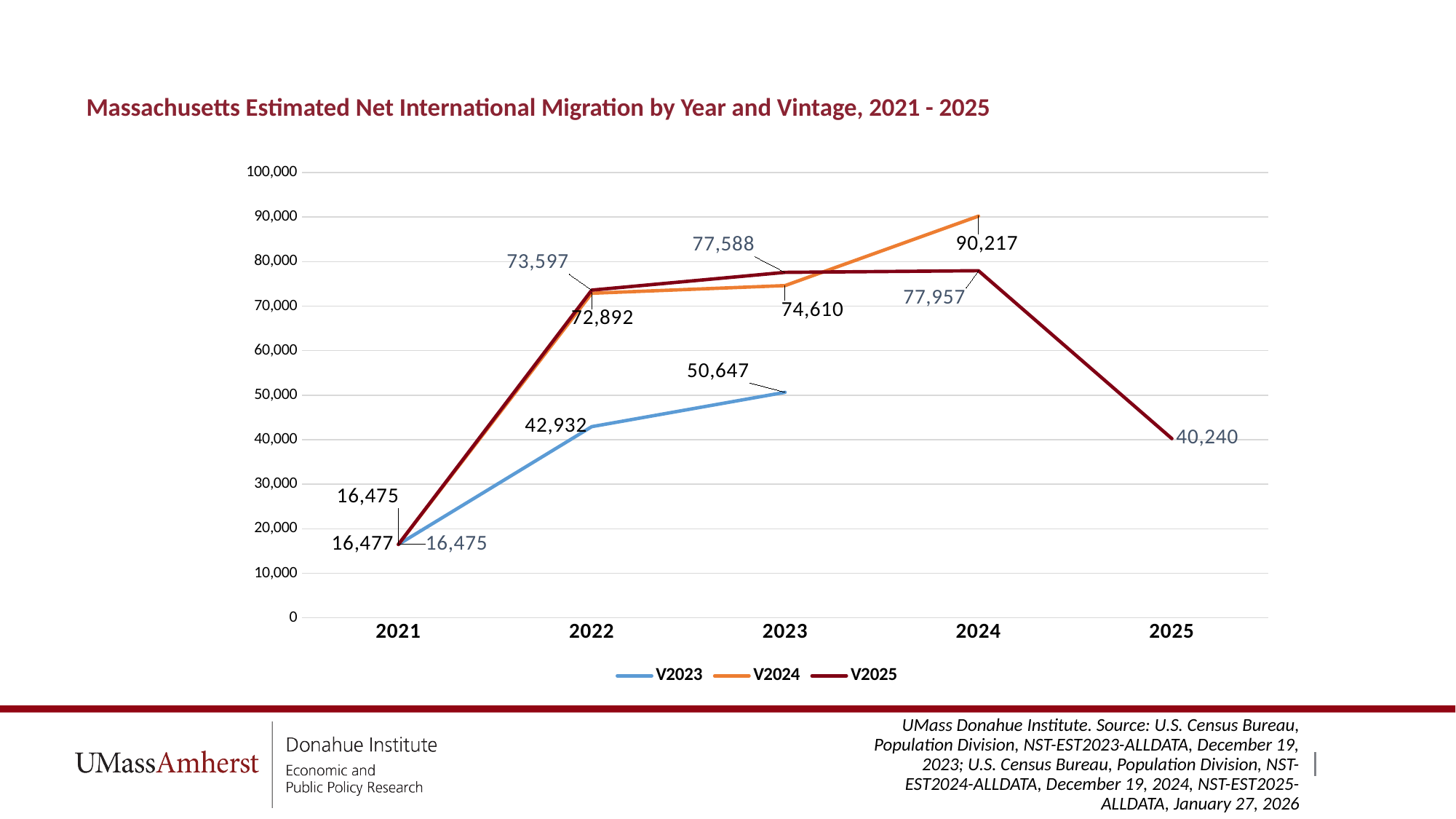
What is the V2025 value for 2025? 40,240 What is the V2024 value for 2022? 72,892 How many years are shown on the x axis? 5 What is the V2023 value for 2023? 50,647 How many series does the legend list? 3 What is the difference between the V2024 and V2025 values for 2024? 12,260 What is the V2025 value for 2022? 73,597 What kind of chart is shown on the slide? line chart What is the V2024 value for 2024? 90,217 In which year does the V2024 series reach its highest value? 2024 Does the V2025 series rise or fall from 2024 to 2025? fall For 2023, which series has the larger value, V2024 or V2025? V2025